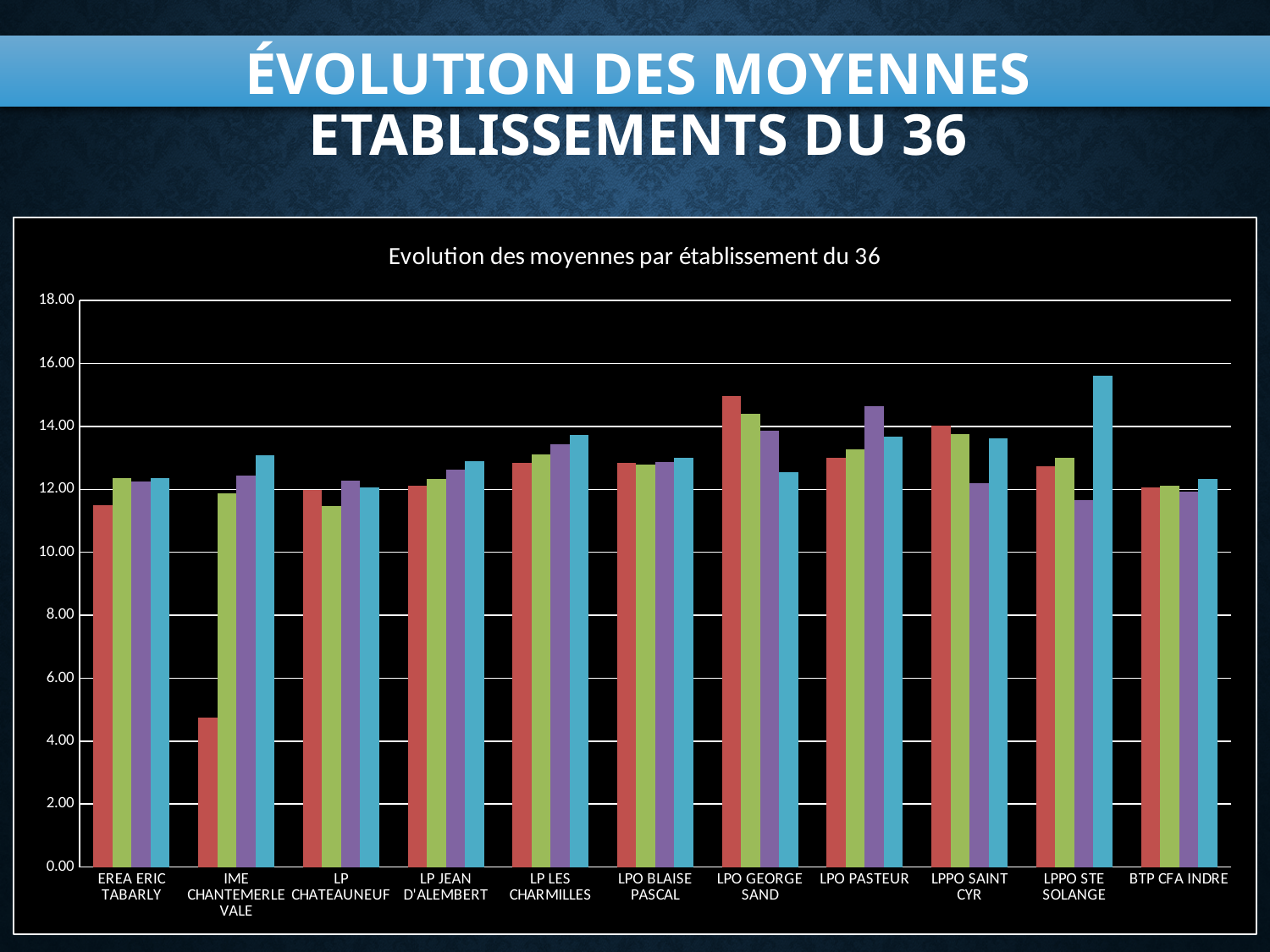
What kind of chart is shown on the slide? Bar chart Is the green bar for LP CHATEAUNEUF greater or less than 12.00? less Which establishment has the lowest bar in the chart? IME CHANTEMERLE VALE How many bars are plotted for each establishment in the chart? 4 What is the maximum value shown on the y axis of the chart? 18.00 Is the red bar for LPO GEORGE SAND greater or less than 14.00? greater What is the title of the chart? Evolution des moyennes par établissement du 36 How many establishments (categories) are shown on the x axis of the chart? 11 Which establishment has the tallest bar in the chart? LPPO STE SOLANGE Which is larger: the red bar for LPO GEORGE SAND or the red bar for EREA ERIC TABARLY? LPO GEORGE SAND Is the blue bar for LPPO STE SOLANGE greater or less than 14.00? greater